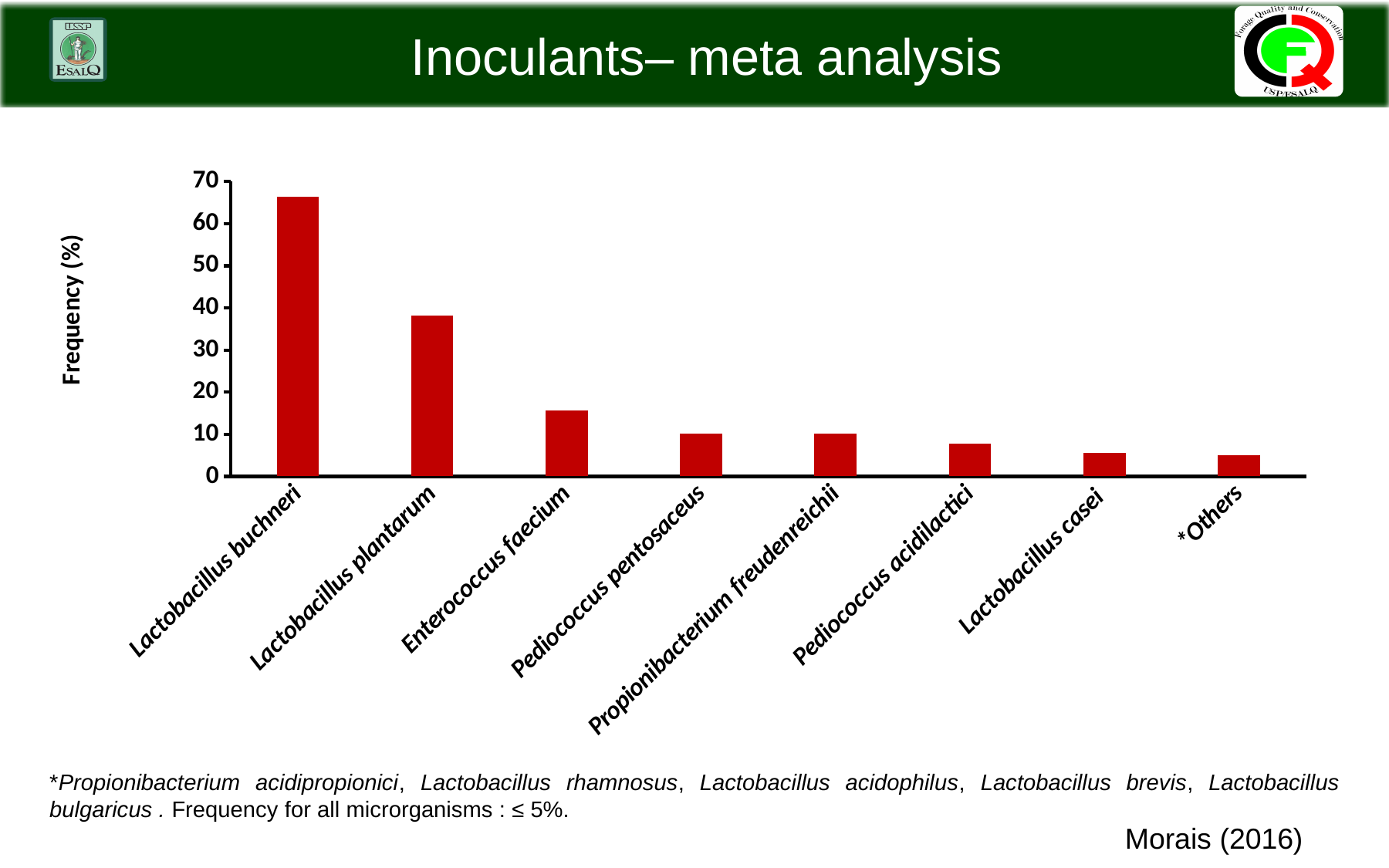
Is the value for Lactobacillus plantarum greater or less than 30? greater Is the value for Pediococcus acidilactici greater or less than 10? less What kind of chart is shown on the slide? bar chart Is the value for Enterococcus faecium greater or less than 20? less Which category has the highest frequency? Lactobacillus buchneri Which is larger, the value for Pediococcus pentosaceus or the value for Lactobacillus casei? Pediococcus pentosaceus What is the label of the vertical axis? Frequency (%) Which is larger, the value for Lactobacillus plantarum or the value for Enterococcus faecium? Lactobacillus plantarum Do the values rise or fall moving from left to right along the x axis? fall How many categories (bars) are plotted in the chart? 8